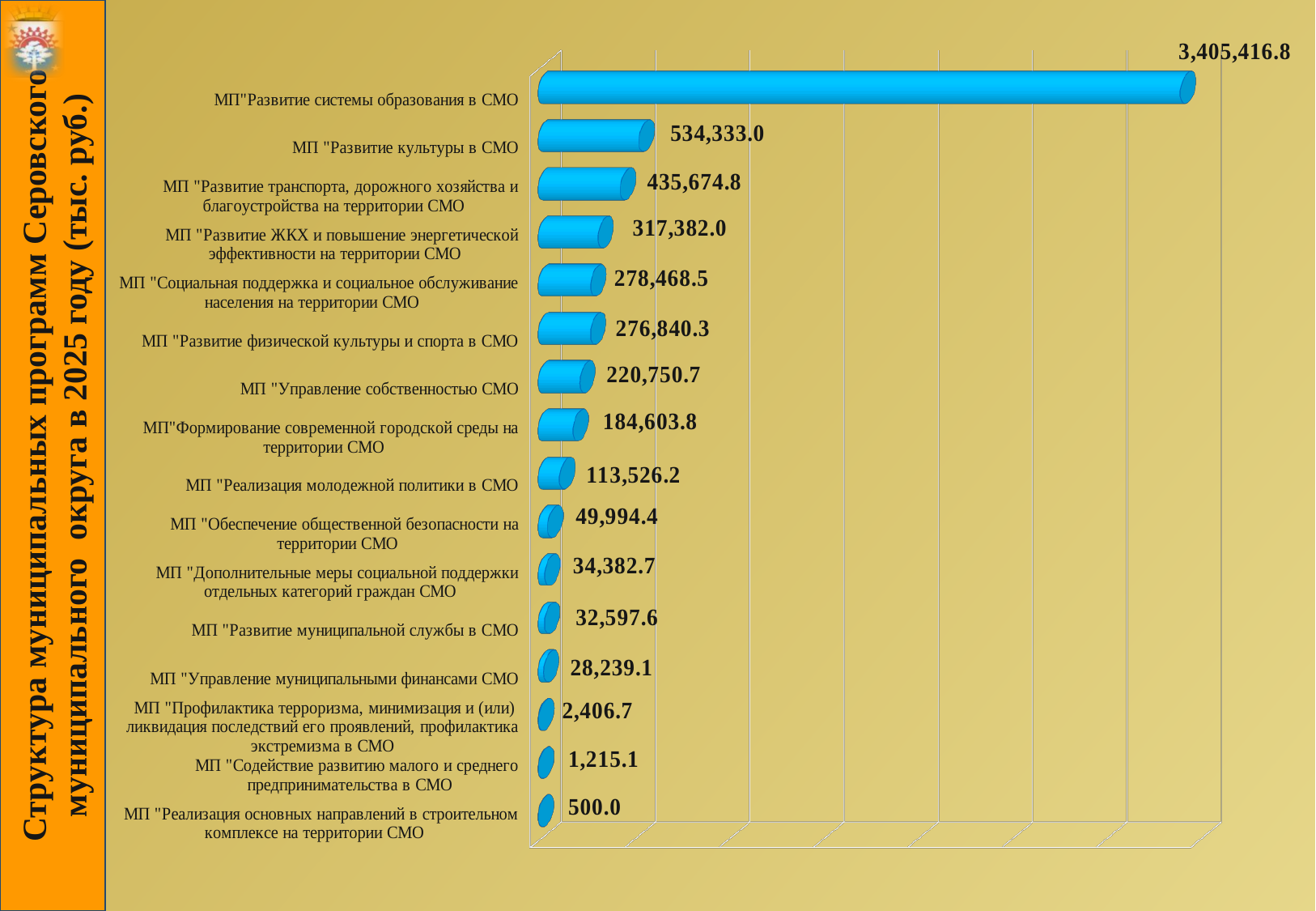
In what units are the values in the chart expressed, according to the slide title? тыс. руб. What is the value for МП "Развитие культуры в СМО"? 534,333.0 Which municipal programme has the lowest value? МП "Реализация основных направлений в строительном комплексе на территории СМО" What is the difference between the values for МП "Обеспечение общественной безопасности на территории СМО" and МП "Дополнительные меры социальной поддержки отдельных категорий граждан СМО"? 15,611.7 What is the difference between the values for МП "Развитие культуры в СМО" and МП "Развитие транспорта, дорожного хозяйства и благоустройства на территории СМО"? 98,658.2 What is the value for МП "Содействие развитию малого и среднего предпринимательства в СМО"? 1,215.1 Which municipal programme has the highest value? МП "Развитие системы образования в СМО" What is the value for МП "Реализация молодежной политики в СМО"? 113,526.2 Which is larger: the value for МП "Развитие ЖКХ и повышение энергетической эффективности на территории СМО" or МП "Формирование современной городской среды на территории СМО"? МП "Развитие ЖКХ и повышение энергетической эффективности на территории СМО" What is the value for МП "Управление собственностью СМО"? 220,750.7 How many municipal programmes are shown in the chart? 16 What kind of chart is shown on the slide? Bar chart